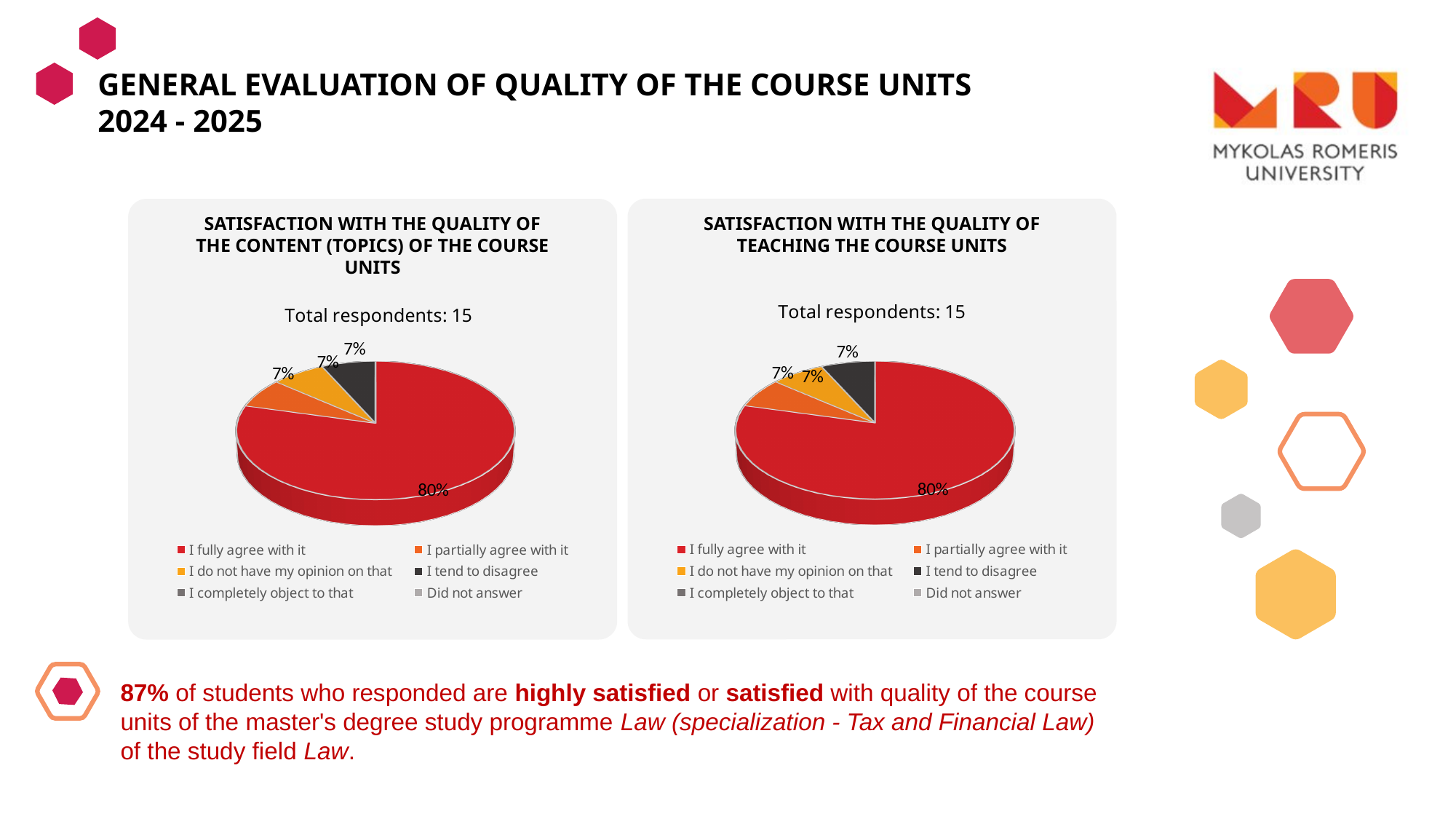
In the 'Satisfaction with the quality of teaching the course units' chart, which response has the largest slice? I fully agree with it In the 'Satisfaction with the quality of the content (topics) of the course units' chart, which is larger: 'I fully agree with it' or 'I do not have my opinion on that'? I fully agree with it How many slices with data labels are shown in the 'Satisfaction with the quality of the content (topics) of the course units' pie? 4 In the 'Satisfaction with the quality of teaching the course units' chart, what share of respondents chose 'I tend to disagree'? 7% What kind of chart is used in the 'Satisfaction with the quality of the content (topics) of the course units' chart? Pie chart In the 'Satisfaction with the quality of the content (topics) of the course units' chart, which response has the largest slice? I fully agree with it How many total respondents are reported for the 'Satisfaction with the quality of teaching the course units' chart? 15 In the 'Satisfaction with the quality of teaching the course units' chart, what share of respondents chose 'I fully agree with it'? 80% In the 'Satisfaction with the quality of the content (topics) of the course units' chart, what share of respondents chose 'I fully agree with it'? 80% In the 'Satisfaction with the quality of the content (topics) of the course units' chart, what share of respondents chose 'I partially agree with it'? 7% How many entries does the legend of the 'Satisfaction with the quality of teaching the course units' chart list? 6 In the 'Satisfaction with the quality of teaching the course units' chart, what is the difference between the 'I fully agree with it' share and the 'I tend to disagree' share? 73%